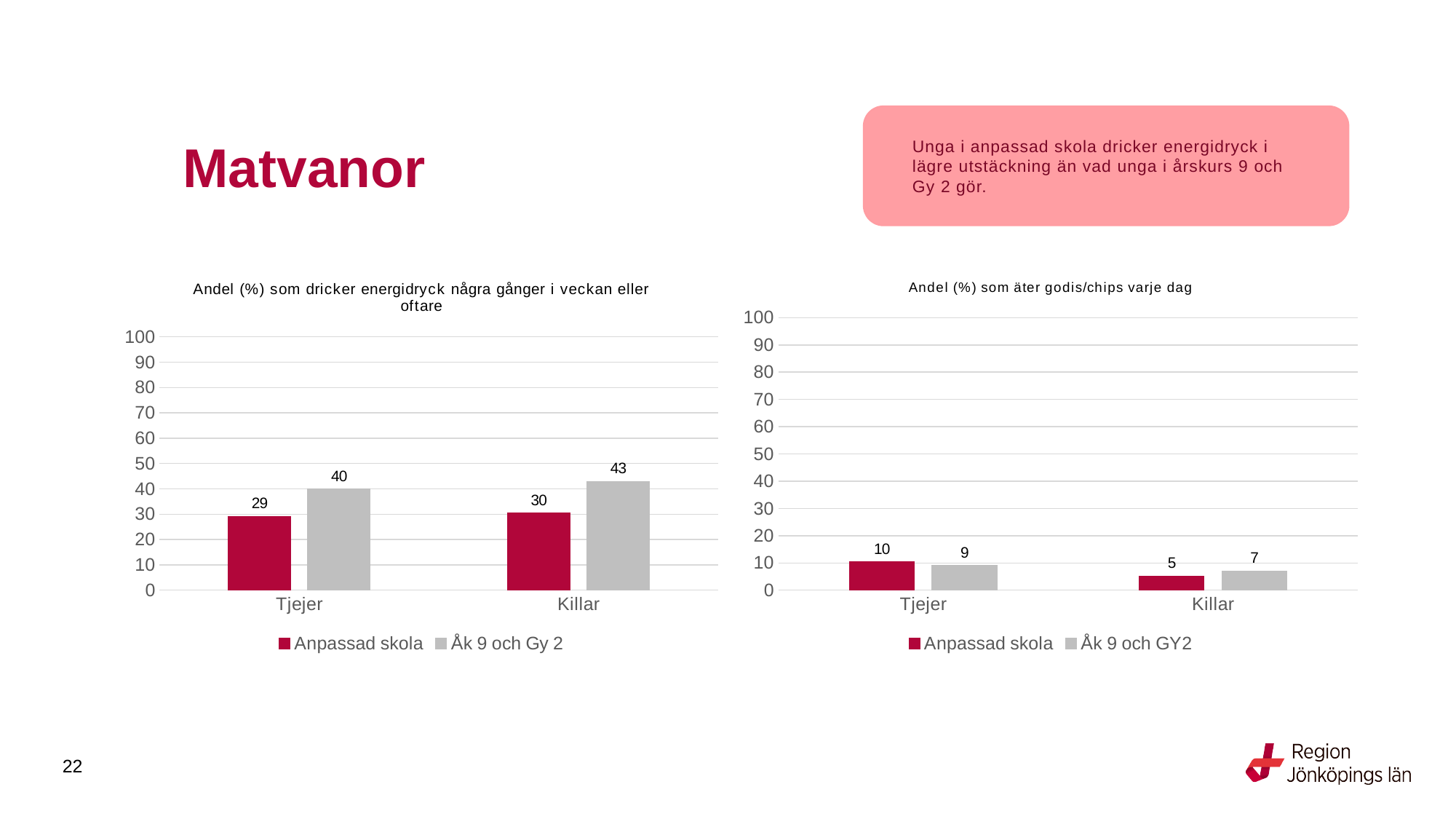
How many series does the legend of the right chart (godis/chips) list? 2 In the left chart (energy drink), which is larger among Killar: Anpassad skola or Åk 9 och Gy 2? Åk 9 och Gy 2 In the right chart (godis/chips), what is the value for Anpassad skola among Tjejer? 10 In the left chart (energy drink), what is the value for Anpassad skola among Tjejer? 29 What is the title of the right chart? Andel (%) som äter godis/chips varje dag In the right chart (godis/chips), what is the difference between Anpassad skola and Åk 9 och GY2 among Tjejer? 1 In the left chart (energy drink), which bar has the highest value? Åk 9 och Gy 2, Killar What kind of chart is the left chart (energy drink)? Bar chart In the left chart (energy drink), what is the value for Åk 9 och Gy 2 among Killar? 43 In the right chart (godis/chips), what is the value for Åk 9 och GY2 among Killar? 7 In the right chart (godis/chips), which bar has the lowest value? Anpassad skola, Killar In the left chart (energy drink), what is the difference between Åk 9 och Gy 2 and Anpassad skola among Tjejer? 11